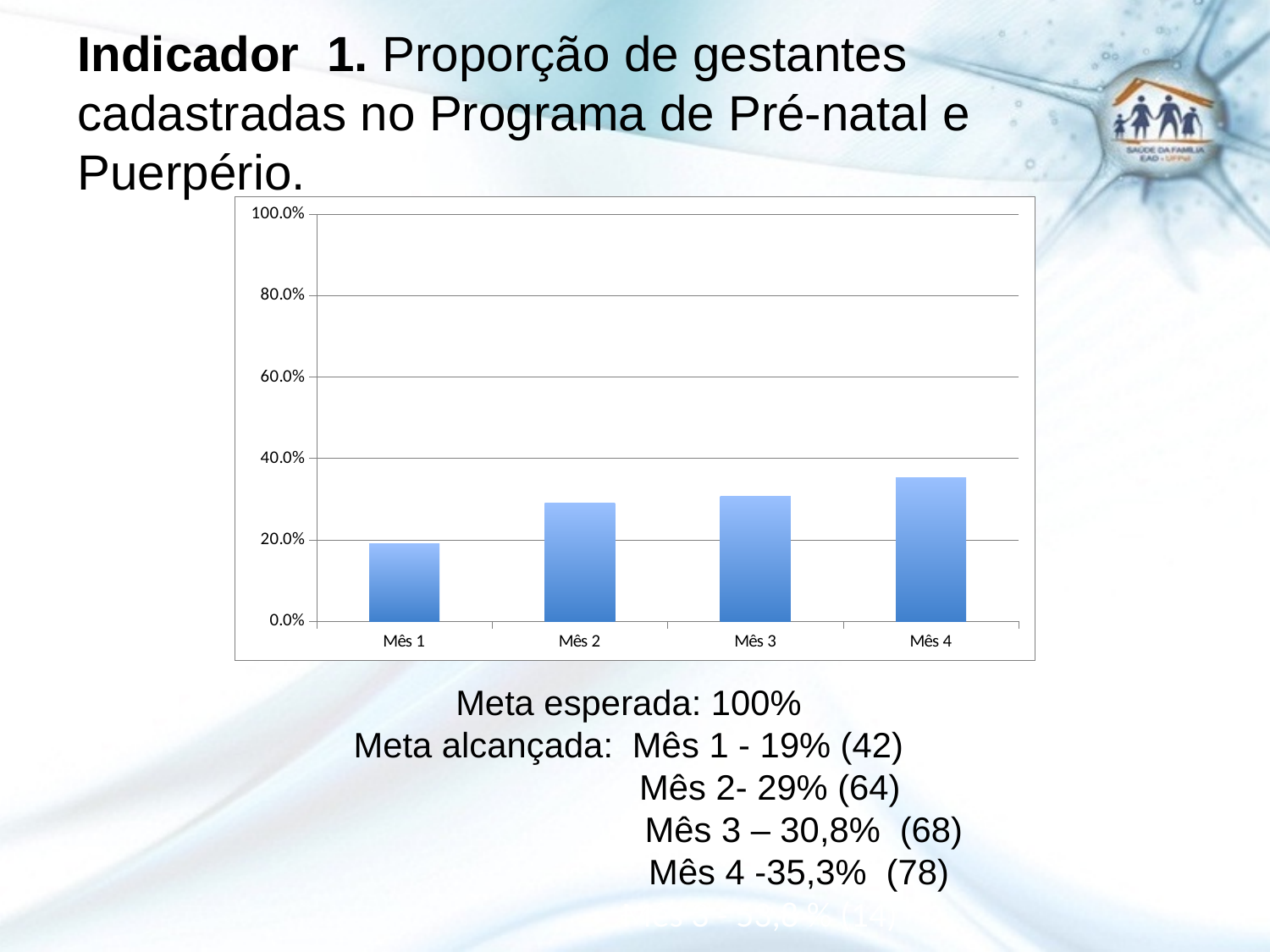
Is the value for Mês 4 greater or less than 40.0%? less According to the text on the slide, what proportion was reached in Mês 4? 35,3% How many categories (months) are plotted on the chart? 4 Is the value for Mês 1 greater or less than 20.0%? less What kind of chart is shown on the slide? bar chart Which month has the lowest bar on the chart? Mês 1 According to the text on the slide, what proportion was reached in Mês 1? 19% Is the value for Mês 2 greater or less than 20.0%? greater Do the values rise or fall from Mês 1 to Mês 4? rise Which is larger, the value for Mês 1 or the value for Mês 3? Mês 3 What is the highest value shown on the chart's vertical axis? 100.0% Which month has the highest bar on the chart? Mês 4